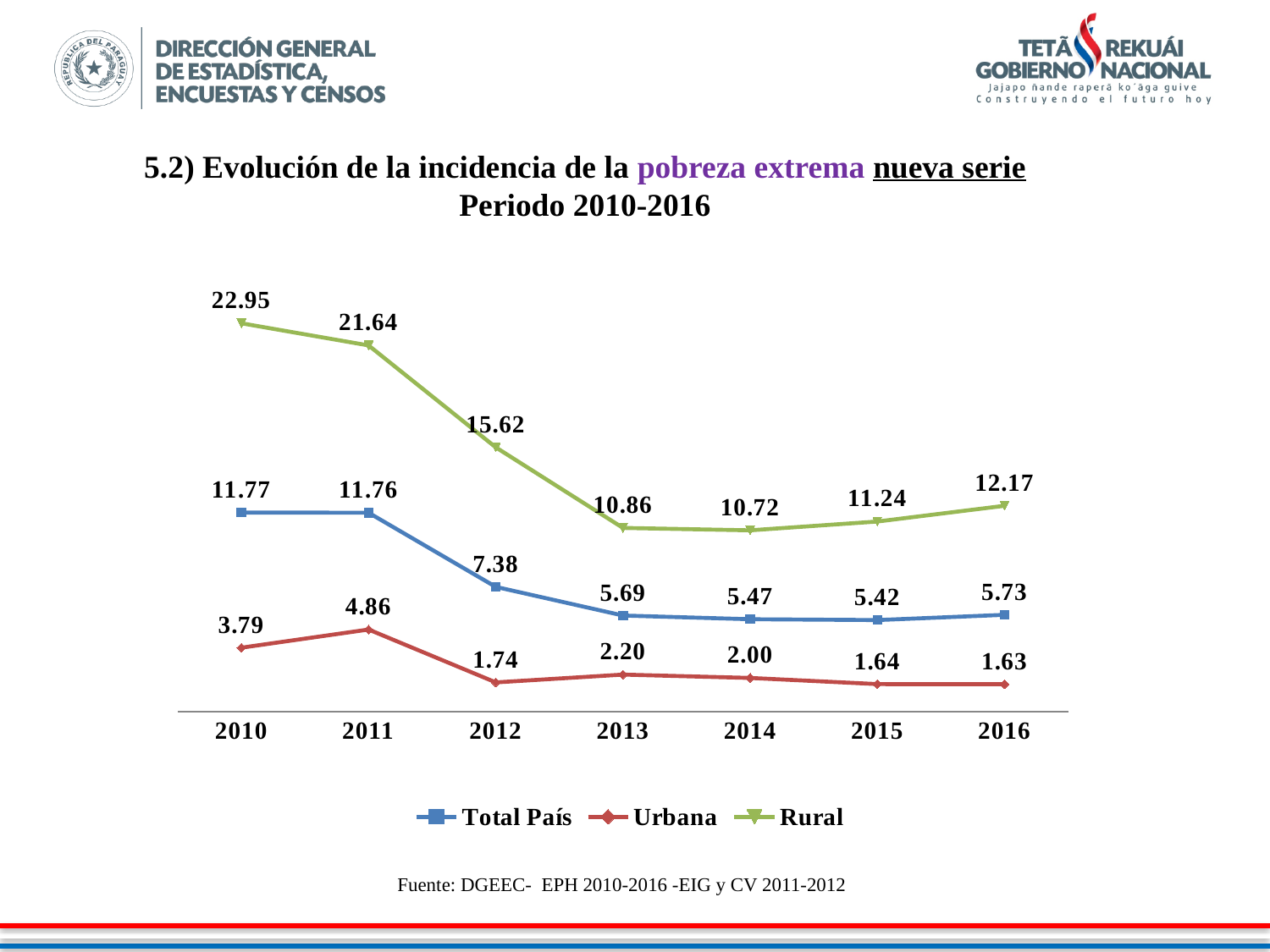
How many years are shown on the x axis? 7 Which is larger, the Total País value in 2012 or the Total País value in 2013? 2012 In which year is the Urbana series at its highest? 2011 What is the Urbana value in 2013? 2.20 How many series does the legend list? 3 Does the Rural series rise or fall from 2010 to 2013? fall What is the Rural value in 2010? 22.95 What is the Total País value in 2016? 5.73 What is the difference between the Rural values in 2010 and 2011? 1.31 Which series is drawn in green? Rural In which year is the Rural series at its lowest? 2014 What kind of chart is shown on the slide? line chart